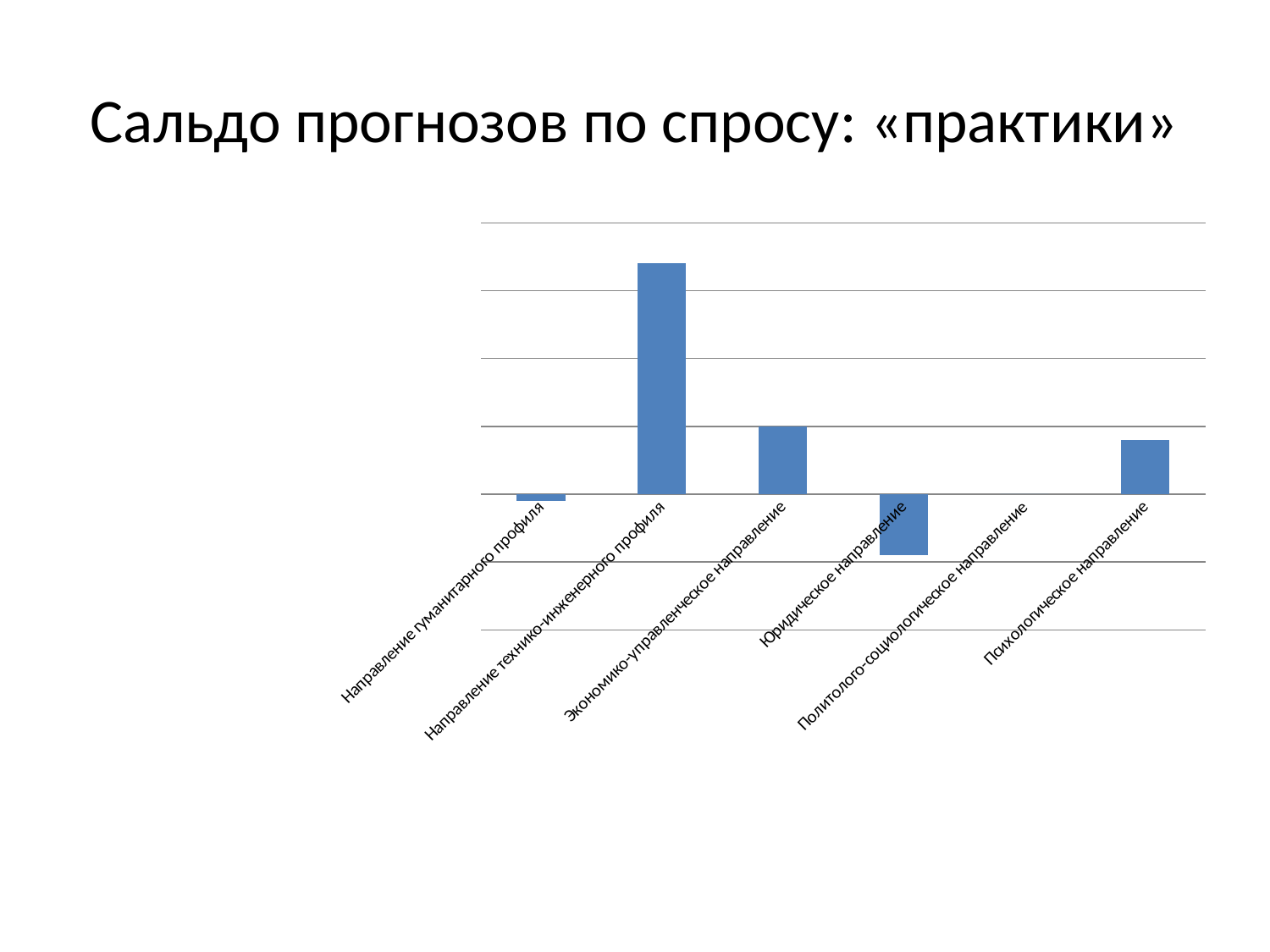
Which is larger: the value for Психологическое направление or for Юридическое направление? Психологическое направление Which is larger: the value for Направление технико-инженерного профиля or for Психологическое направление? Направление технико-инженерного профиля Which category has the lowest value in the chart? Юридическое направление What kind of chart is shown on the slide? bar chart What is the title of the slide with the chart? Сальдо прогнозов по спросу: «практики» How many categories are shown on the x axis of the chart? 6 Which is larger: the value for Направление гуманитарного профиля or for Юридическое направление? Направление гуманитарного профиля Which category has the highest value in the chart? Направление технико-инженерного профиля Which category shows no visible bar (a value at the zero line)? Политолого-социологическое направление How many categories in the chart have a bar below the zero line? 2